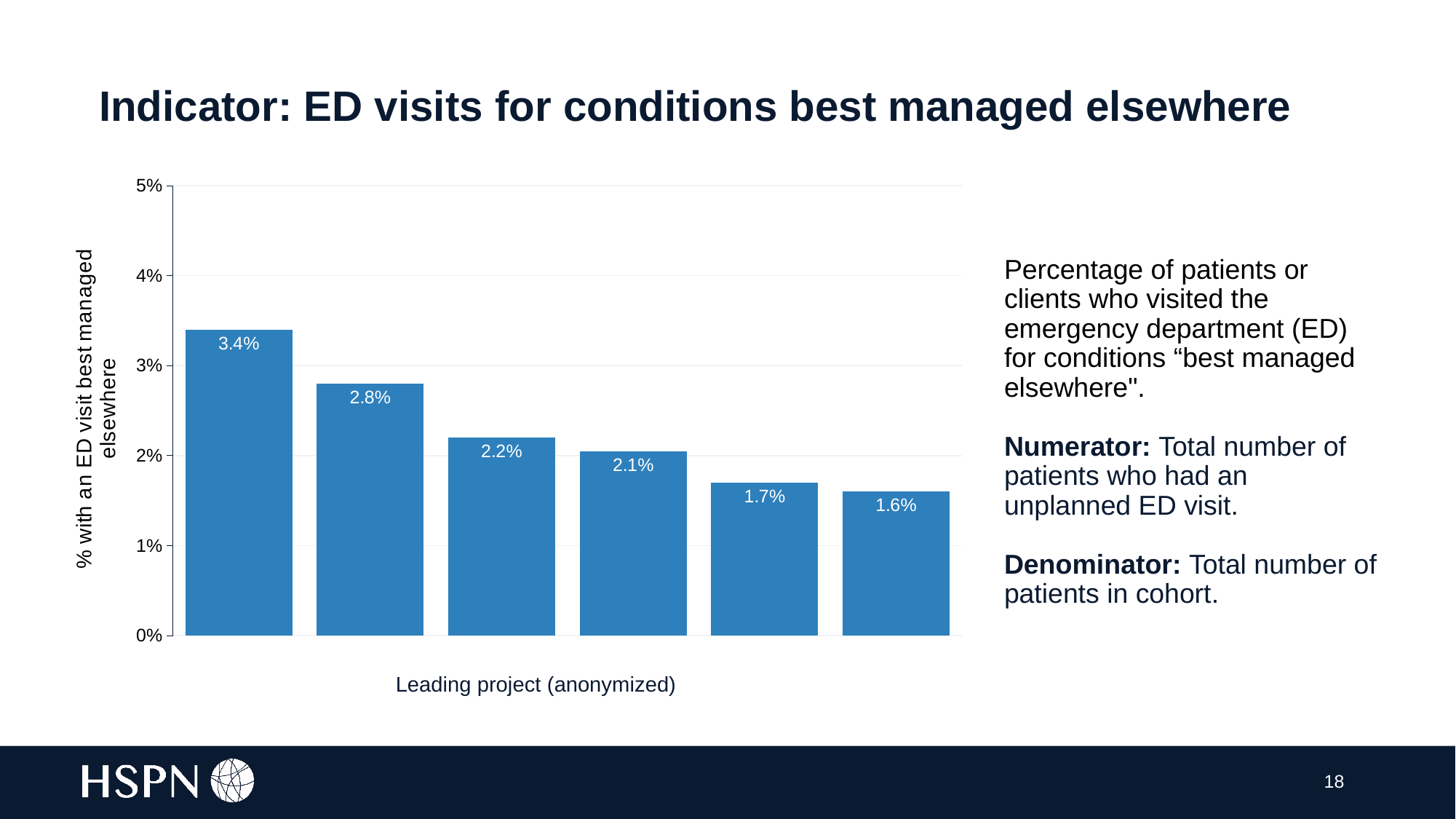
Do the bar values rise or fall from left to right along the x axis? Fall What is the highest value shown among the bars? 3.4% Which is larger, the value of the second bar or the value of the fifth bar? The second bar (2.8%) What kind of chart is shown on the slide? Bar chart Is the value of the first bar greater or less than 3%? greater What is the difference between the first bar (3.4%) and the second bar (2.8%)? 0.6% How many bars (projects) are shown in the chart? 6 What is the difference between the highest bar and the lowest bar? 1.8% What is the value of the third bar from the left? 2.2% What is the value of the first (leftmost) bar in the chart? 3.4% What is the value of the last (rightmost) bar in the chart? 1.6% What is the lowest value shown among the bars? 1.6%